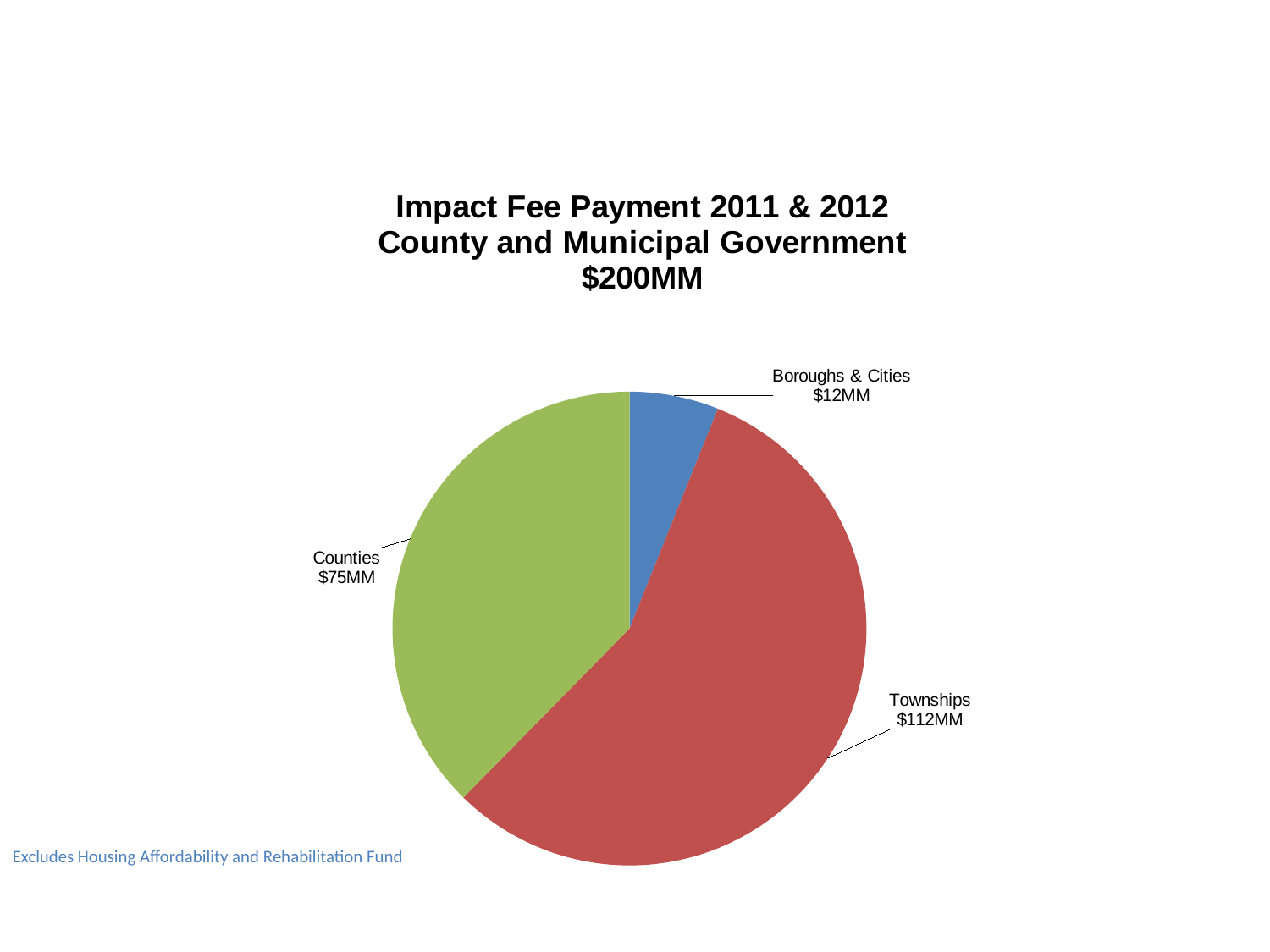
What type of chart is shown on the slide? pie chart How much larger is the Townships payment than the Counties payment? $37MM What colour is the Townships slice? red Which category received the smallest impact fee payment? Boroughs & Cities How many categories are shown in the pie chart? 3 What is the difference between the Townships payment and the Boroughs & Cities payment? $100MM Which is larger, the payment to Counties or the payment to Boroughs & Cities? Counties What is the impact fee payment value for Counties? $75MM What is the impact fee payment value for Townships? $112MM What total amount is stated in the chart title? $200MM Which category received the largest impact fee payment? Townships What is the impact fee payment value for Boroughs & Cities? $12MM